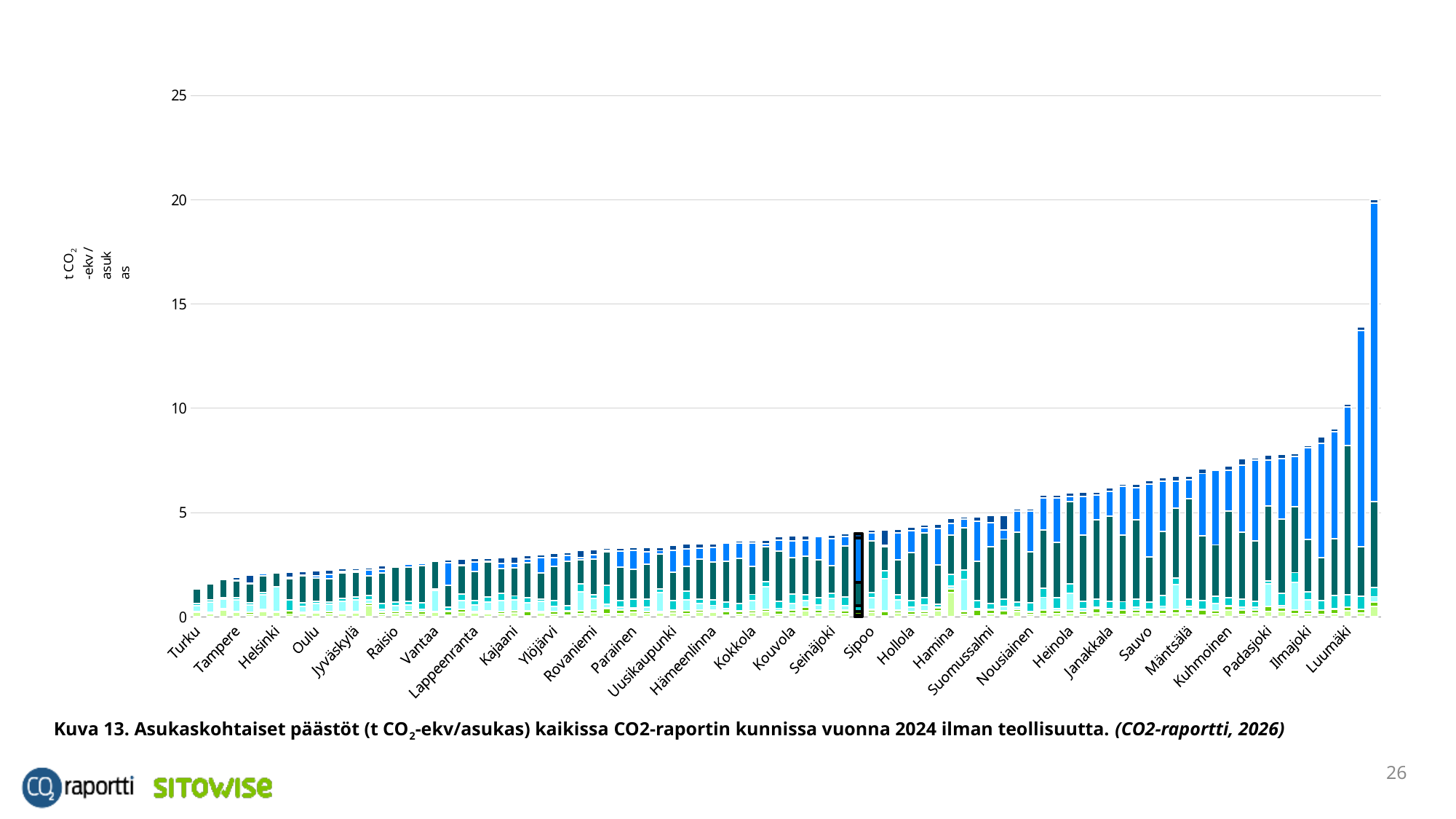
Is the tallest bar in the chart greater or less than 15? greater Which has the larger value, Turku or Ilmajoki? Ilmajoki Is the value for Sipoo greater or less than 5? less Which has the larger value, Tampere or Sauvo? Sauvo Is the value for Padasjoki greater or less than 5? greater Do the bar heights rise or fall from left to right along the x axis? Rise What kind of chart is shown on the slide? Stacked bar chart What is the highest value shown on the y axis? 25